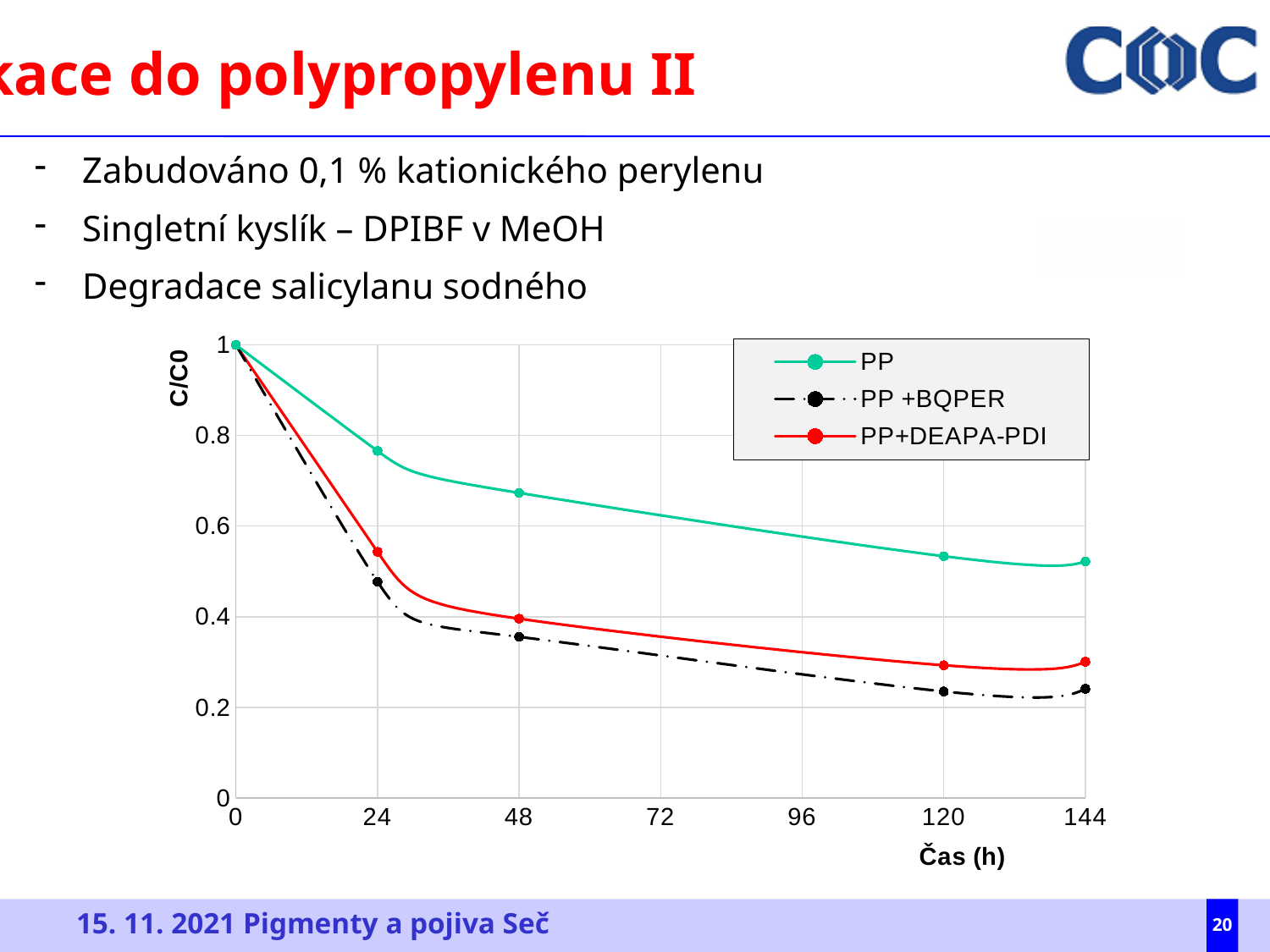
Is the C/C0 value for PP +BQPER at 144 h greater or less than 0.4? less Is the C/C0 value for PP+DEAPA-PDI at 120 h greater or less than 0.4? less Which series has the lowest C/C0 value at 120 h? PP +BQPER What is the C/C0 value of the PP series at time 0 h? 1 How many series does the chart legend list? 3 Is the C/C0 value for PP at 24 h greater or less than 0.6? greater What is the title of the x axis of the chart? Čas (h) What kind of chart is shown on the slide? line chart At 48 h, which series has the larger C/C0 value, PP or PP +BQPER? PP How many data points are plotted for the PP series? 5 Do the C/C0 values of the PP series rise or fall as time increases along the x axis? fall Which series has the highest C/C0 value at 144 h? PP